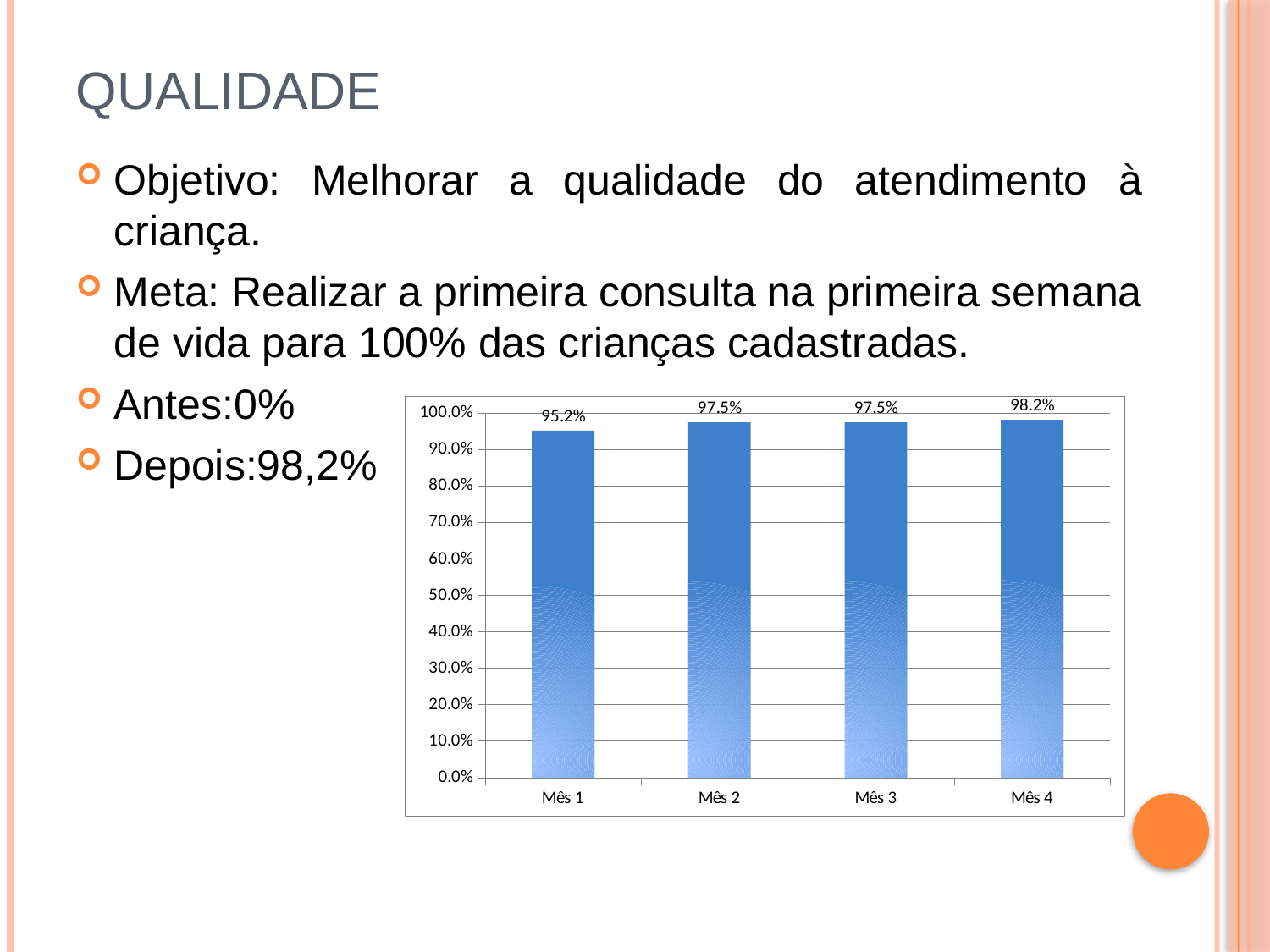
What is the highest tick value shown on the y axis? 100.0% Which is larger, the value for Mês 1 or the value for Mês 4? Mês 4 Which month has the highest value? Mês 4 Do the values generally rise or fall from Mês 1 to Mês 4? rise Which month has the lowest value? Mês 1 What is the difference between the values for Mês 4 and Mês 1? 3.0% What kind of chart is shown on the slide? bar chart Is the value for Mês 1 greater or less than 90.0%? greater What is the value for Mês 2? 97.5% How many months are shown on the x axis? 4 What is the value for Mês 4? 98.2% What is the value for Mês 1? 95.2%